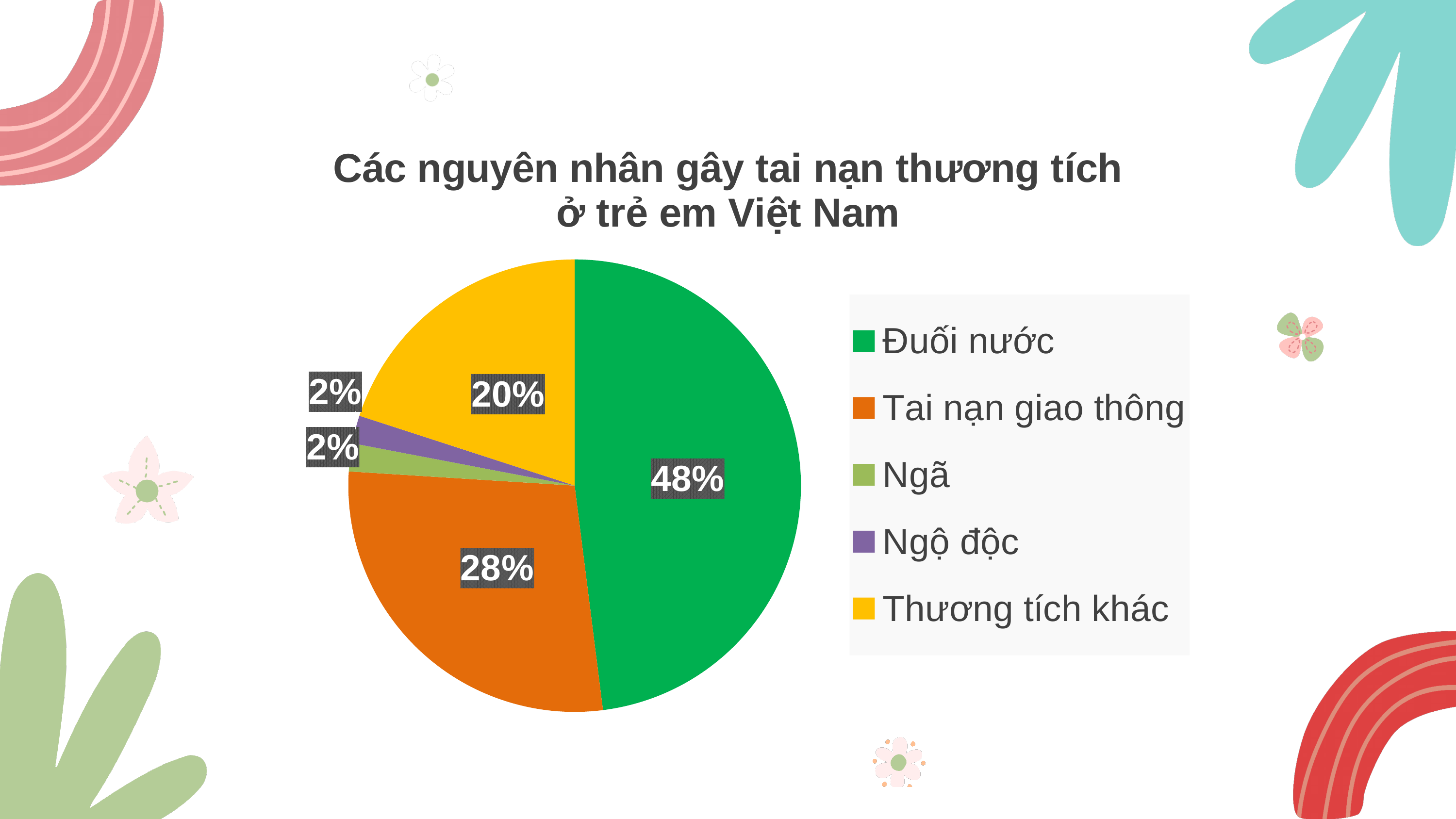
What is the difference between the shares of Thương tích khác and Ngã? 18% What share of the pie does Đuối nước account for? 48% What is the value shown for Thương tích khác? 20% What kind of chart is shown on the slide? pie chart What is the value shown for Tai nạn giao thông? 28% How many categories does the legend list? 5 Which is larger, the share for Tai nạn giao thông or the share for Thương tích khác? Tai nạn giao thông Which colour represents Thương tích khác in the chart? yellow What is the difference between the shares of Đuối nước and Tai nạn giao thông? 20% Which category has the largest slice of the pie? Đuối nước What is the title of the chart? Các nguyên nhân gây tai nạn thương tích ở trẻ em Việt Nam What is the value shown for Ngộ độc? 2%